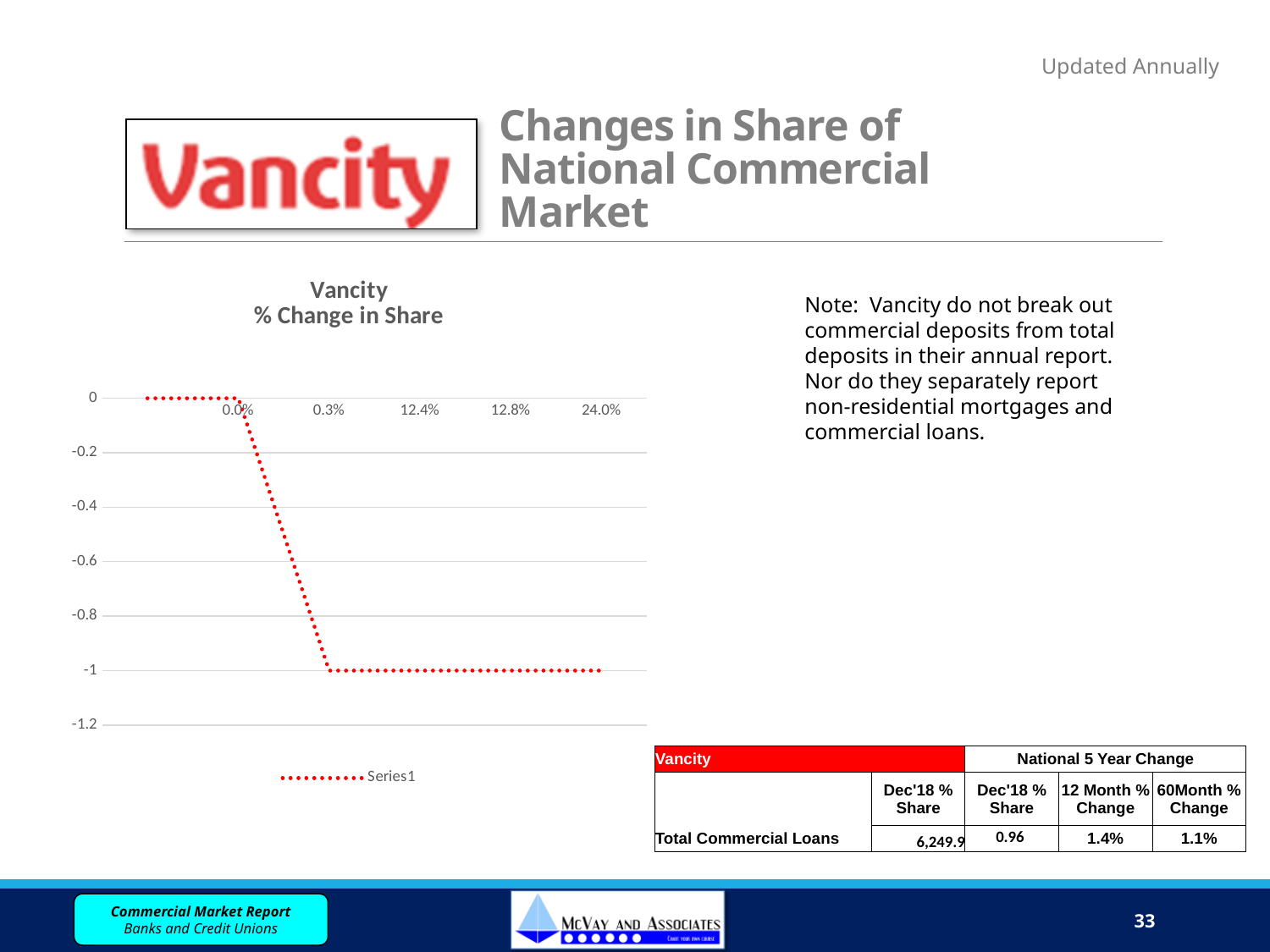
Do the plotted values rise or fall moving from left to right along the x axis? fall What is the value plotted at the 0.0% category? 0 What is the title of the chart? Vancity % Change in Share What is the name of the series shown in the legend? Series1 What is the value plotted at the 24.0% category? -1 Which has the larger value, the 0.0% category or the 0.3% category? 0.0% What is the difference between the value at 0.0% and the value at 0.3%? 1 What kind of chart is shown on the slide? line chart How many series does the chart's legend list? 1 What is the value plotted at the 12.8% category? -1 Is the value at the 12.4% category greater or less than -0.6? less How many category labels are shown along the x axis of the chart? 5